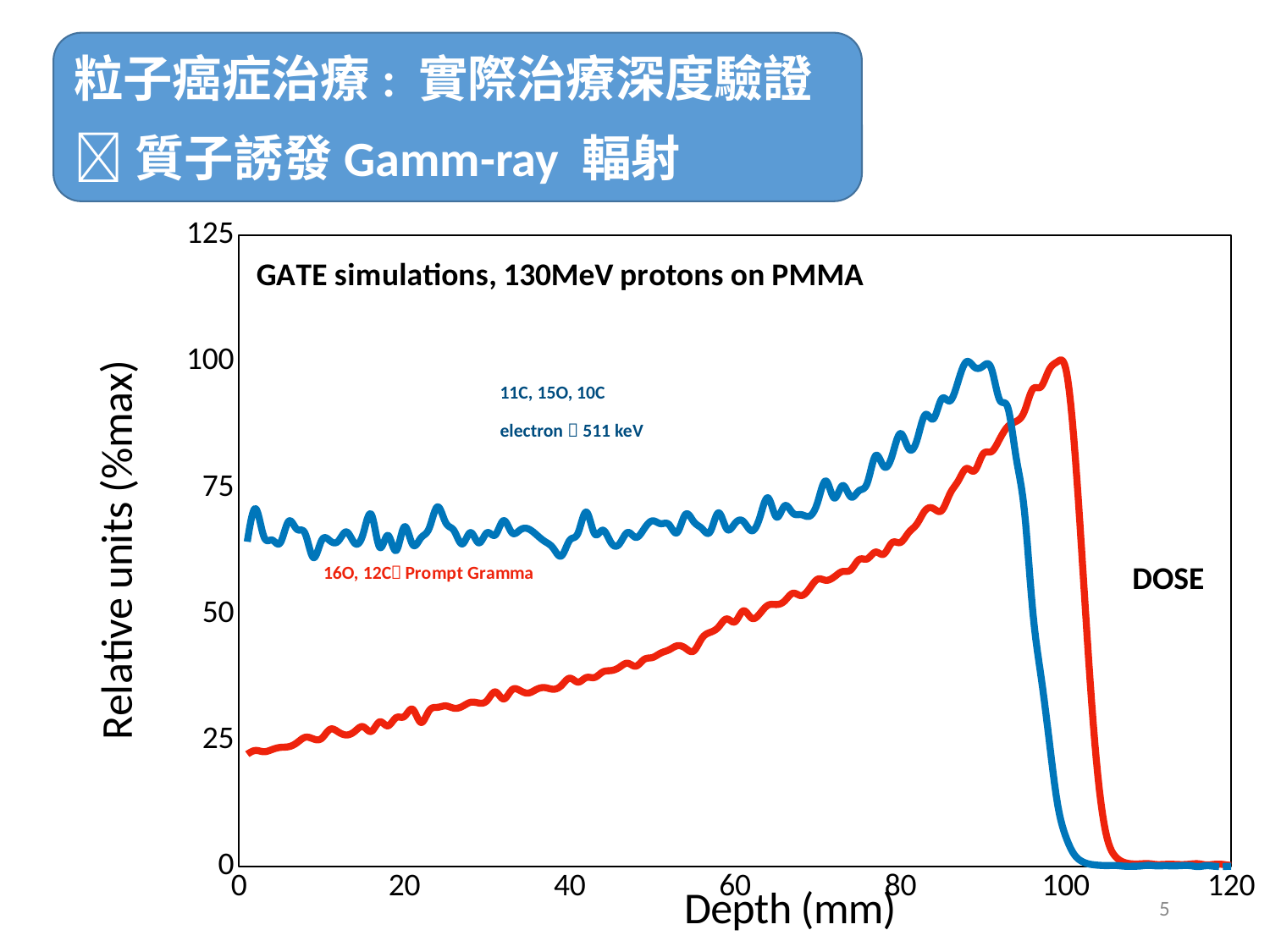
Is the value of the blue curve at a depth of 120 mm greater or less than 25? less What kind of chart is shown on the slide? line chart Does the blue curve rise or fall between depths of 90 mm and 100 mm? fall Is the value of the red curve at a depth of 0 mm greater or less than 50? less What is the title printed inside the chart area? GATE simulations, 130MeV protons on PMMA Does the red curve rise or fall between depths of 0 mm and 80 mm? rise At a depth of 40 mm, which curve has the larger value, the blue curve or the red curve? blue curve Is the value of the blue curve at a depth of 0 mm greater or less than 50? greater Which curve reaches its peak at a greater depth, the blue curve or the red curve? red curve What is the label of the x axis? Depth (mm) How many curves are plotted on the chart? 2